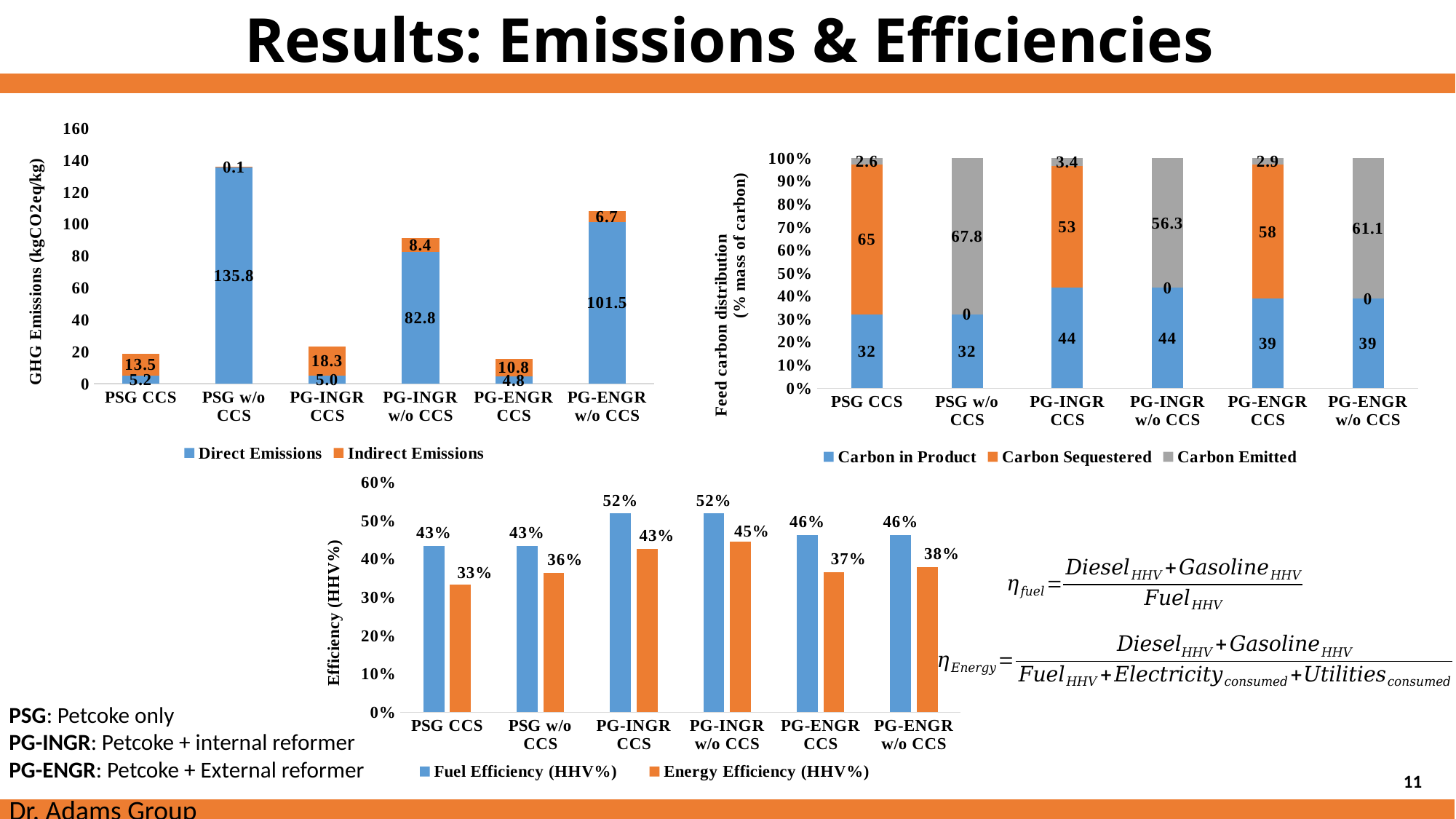
In the Feed carbon distribution chart (top right), what is the Carbon Emitted value for PSG w/o CCS? 67.8 In the GHG Emissions chart (top left), what is the Direct Emissions value for PSG w/o CCS? 135.8 What kind of chart is the Efficiency chart at the bottom of the slide? Bar chart In the GHG Emissions chart (top left), what is the difference between the Direct Emissions of PG-ENGR w/o CCS and PG-INGR w/o CCS? 18.7 In the Feed carbon distribution chart (top right), what is the Carbon Sequestered value for PG-ENGR CCS? 58 In the Efficiency chart (bottom), what is the Energy Efficiency (HHV%) for PG-INGR w/o CCS? 45% In the GHG Emissions chart (top left), what is the Indirect Emissions value for PG-INGR CCS? 18.3 In the Feed carbon distribution chart (top right), which category has the lowest Carbon Emitted value? PSG CCS In the Feed carbon distribution chart (top right), how many series does the legend list? 3 In the GHG Emissions chart (top left), which category has the highest Direct Emissions? PSG w/o CCS In the Efficiency chart (bottom), which is larger for PSG CCS: Fuel Efficiency or Energy Efficiency? Fuel Efficiency In the GHG Emissions chart (top left), what is the total of the stacked bar for PG-ENGR w/o CCS? 108.2